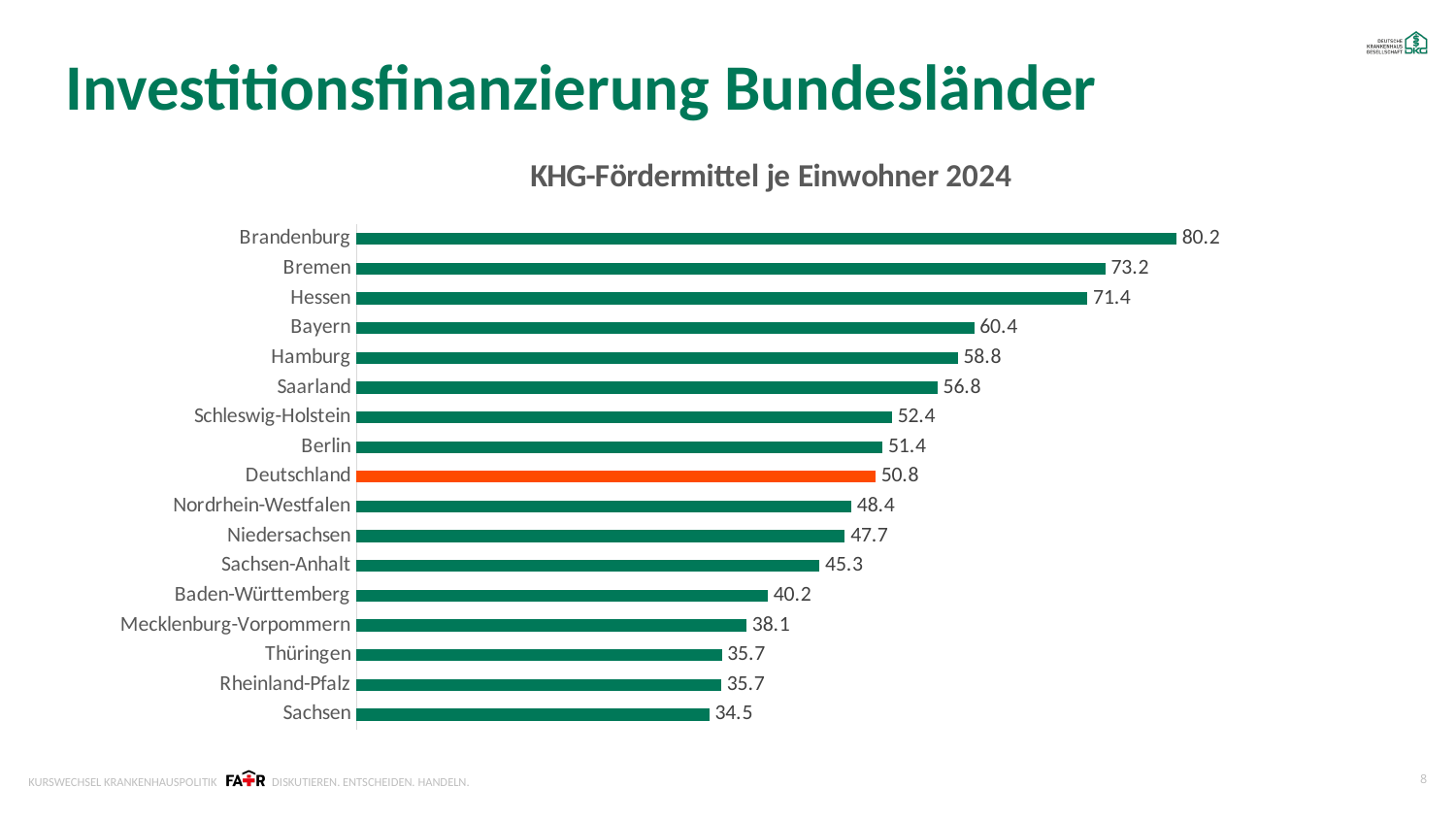
What kind of chart is shown on the slide? Bar chart Which has a larger value, Niedersachsen or Sachsen-Anhalt? Niedersachsen What is the value for Deutschland in the chart? 50.8 Which category has the highest value in the chart? Brandenburg Which has a larger value, Bayern or Hamburg? Bayern What is the difference between the values for Bremen and Hessen? 1.8 Which category's bar is shown in a different colour (orange) from the others? Deutschland Which category has the lowest value in the chart? Sachsen What is the difference between the values for Brandenburg and Sachsen? 45.7 How many categories are shown in the chart? 17 What is the value for Mecklenburg-Vorpommern? 38.1 What is the value for Brandenburg in the KHG-Fördermittel je Einwohner 2024 chart? 80.2